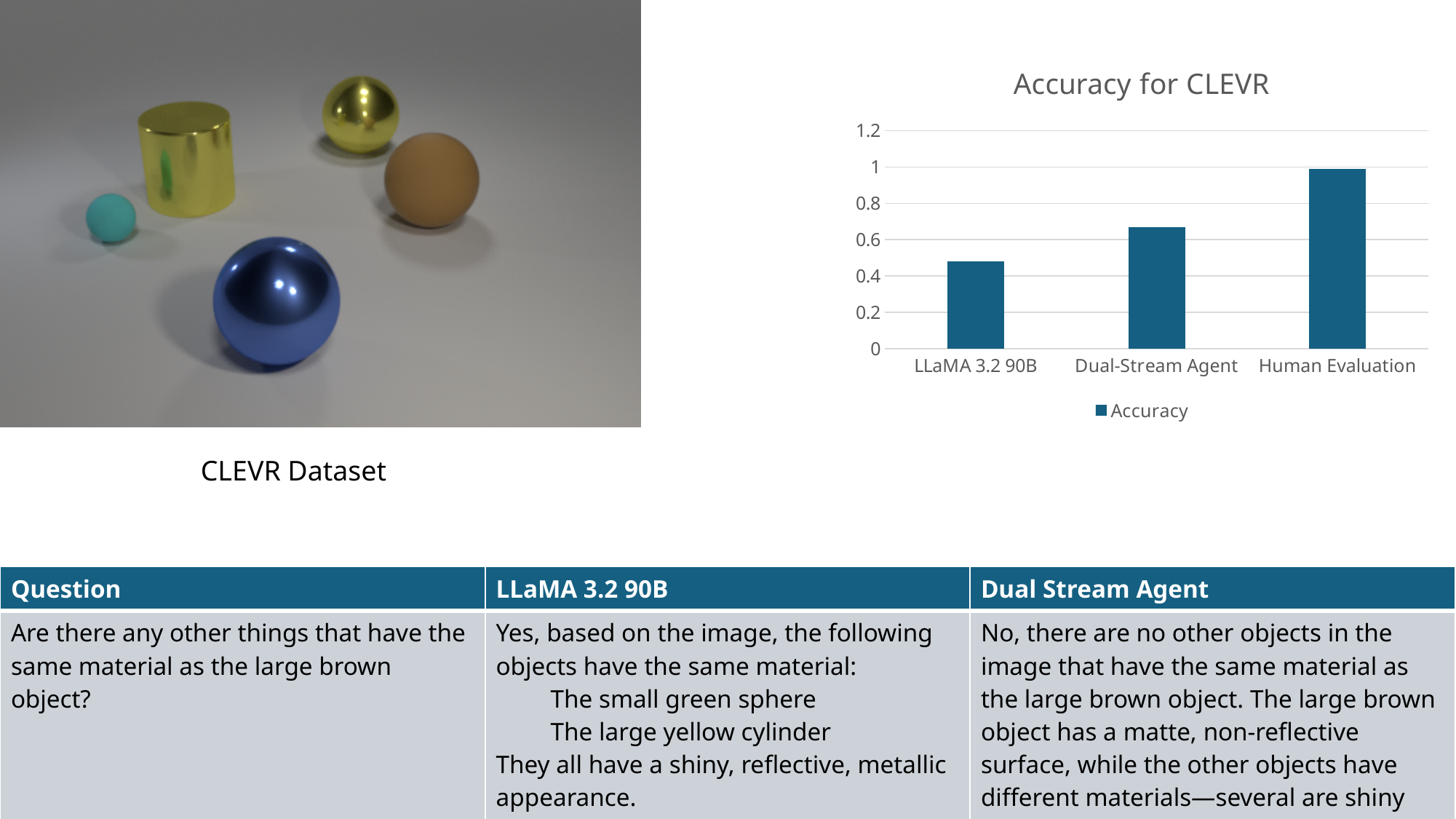
Is the accuracy for Dual-Stream Agent greater or less than 0.6? greater What is the title of the chart? Accuracy for CLEVR How many series does the chart's legend list? 1 What kind of chart is shown on the slide? bar chart Which category has the highest accuracy in the chart? Human Evaluation Do the accuracy values rise or fall from left to right across the categories? rise Which category has the lowest accuracy in the chart? LLaMA 3.2 90B Is the accuracy for LLaMA 3.2 90B greater or less than 0.6? less Which has a higher accuracy, LLaMA 3.2 90B or Dual-Stream Agent? Dual-Stream Agent How many categories are plotted in the chart? 3 What series name is shown in the chart's legend? Accuracy Is the accuracy for Human Evaluation greater or less than 0.8? greater